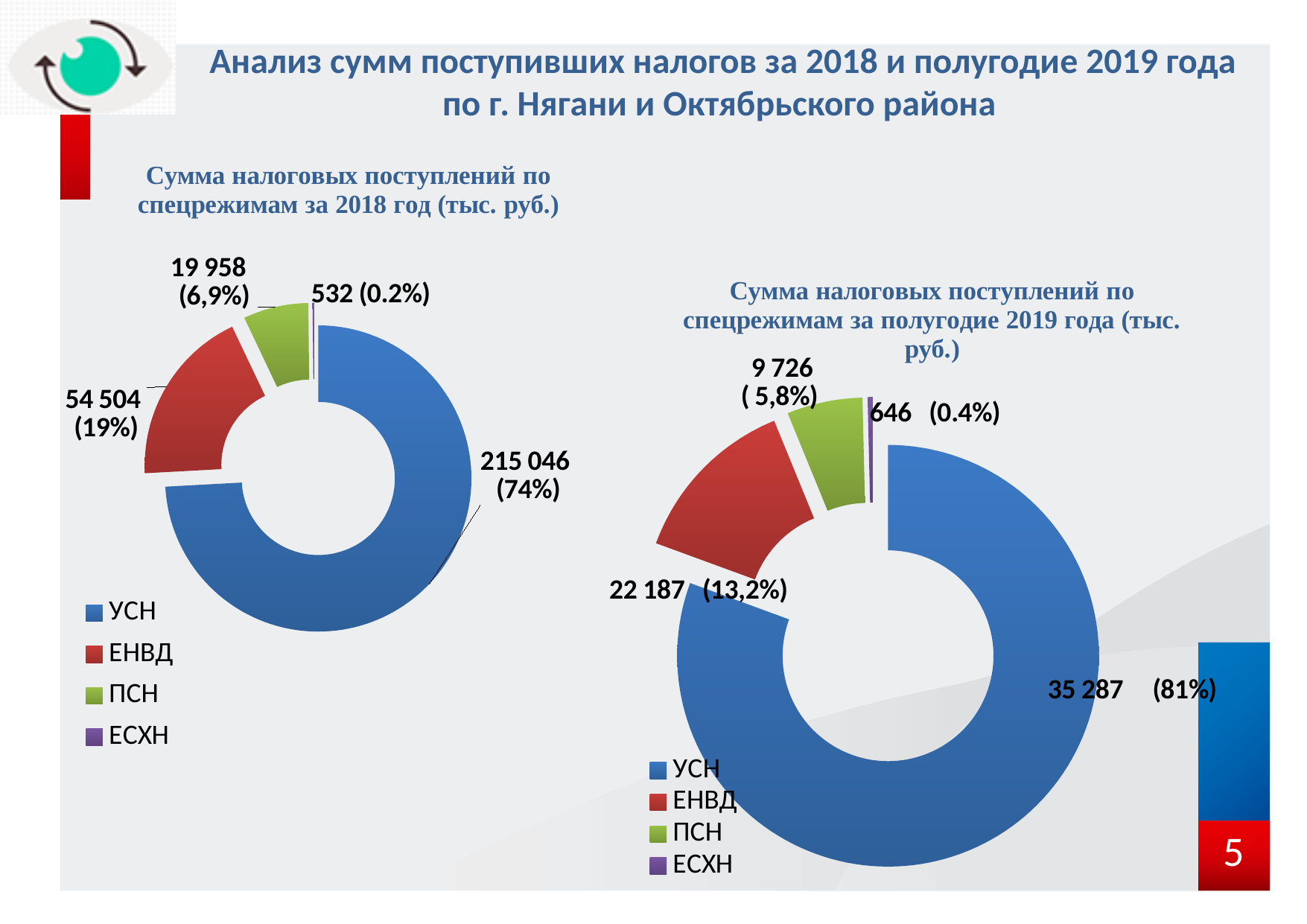
In the left chart (2018), what is the value for ЕНВД? 54 504 In the right chart (half-year 2019), what share of the total does УСН account for? 81% How many categories does the legend of the left chart (2018) list? 4 In the left chart (2018), what is the value for УСН? 215 046 What kind of chart is the right chart (half-year 2019)? Doughnut chart In the right chart (half-year 2019), which category has the smallest value? ЕСХН In the right chart (half-year 2019), what is the value for ЕСХН? 646 In the left chart (2018), what share of the total does ЕНВД account for? 19% In the right chart (half-year 2019), what is the value for ПСН? 9 726 In the right chart (half-year 2019), which is larger, the value for ЕНВД or the value for ПСН? ЕНВД In the left chart (2018), what is the difference between the values for ЕНВД and ПСН? 34 546 In the left chart (2018), which category has the largest value? УСН